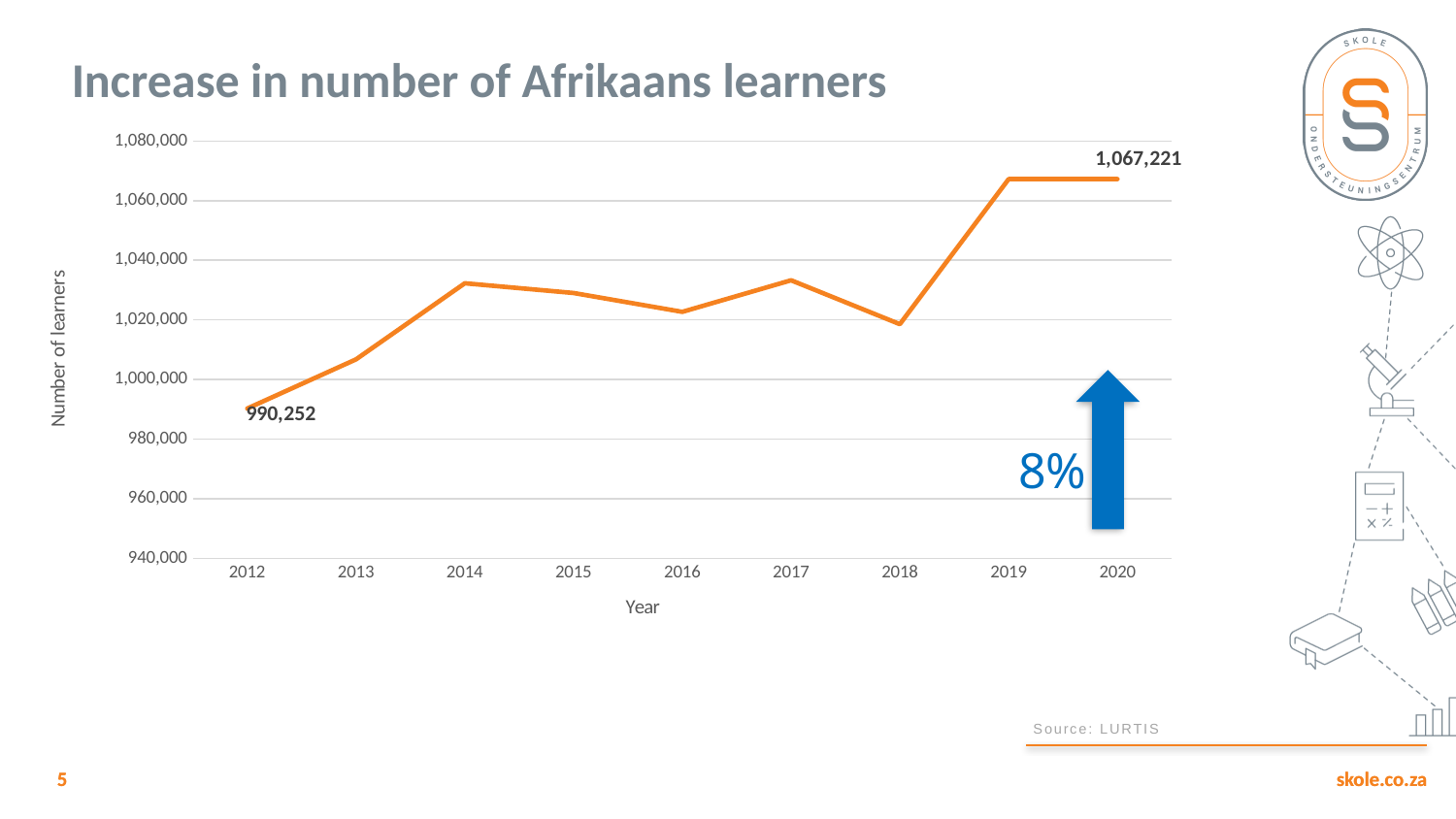
Is the value for 2018 greater or less than 1,040,000? less Overall, does the number of Afrikaans learners rise or fall from 2012 to 2020? Rise What is the number of Afrikaans learners in 2012? 990,252 Is the value for 2013 greater or less than 1,020,000? less What is the label on the y axis of the chart? Number of learners What type of chart is shown on the slide? Line chart By how much did the number of Afrikaans learners increase from 2012 to 2020? 76,969 How many years are plotted on the x axis? 9 What is the number of Afrikaans learners in 2020? 1,067,221 Which year has the larger value, 2017 or 2018? 2017 Is the value for 2014 greater or less than 1,020,000? greater Which year has the lowest number of Afrikaans learners? 2012